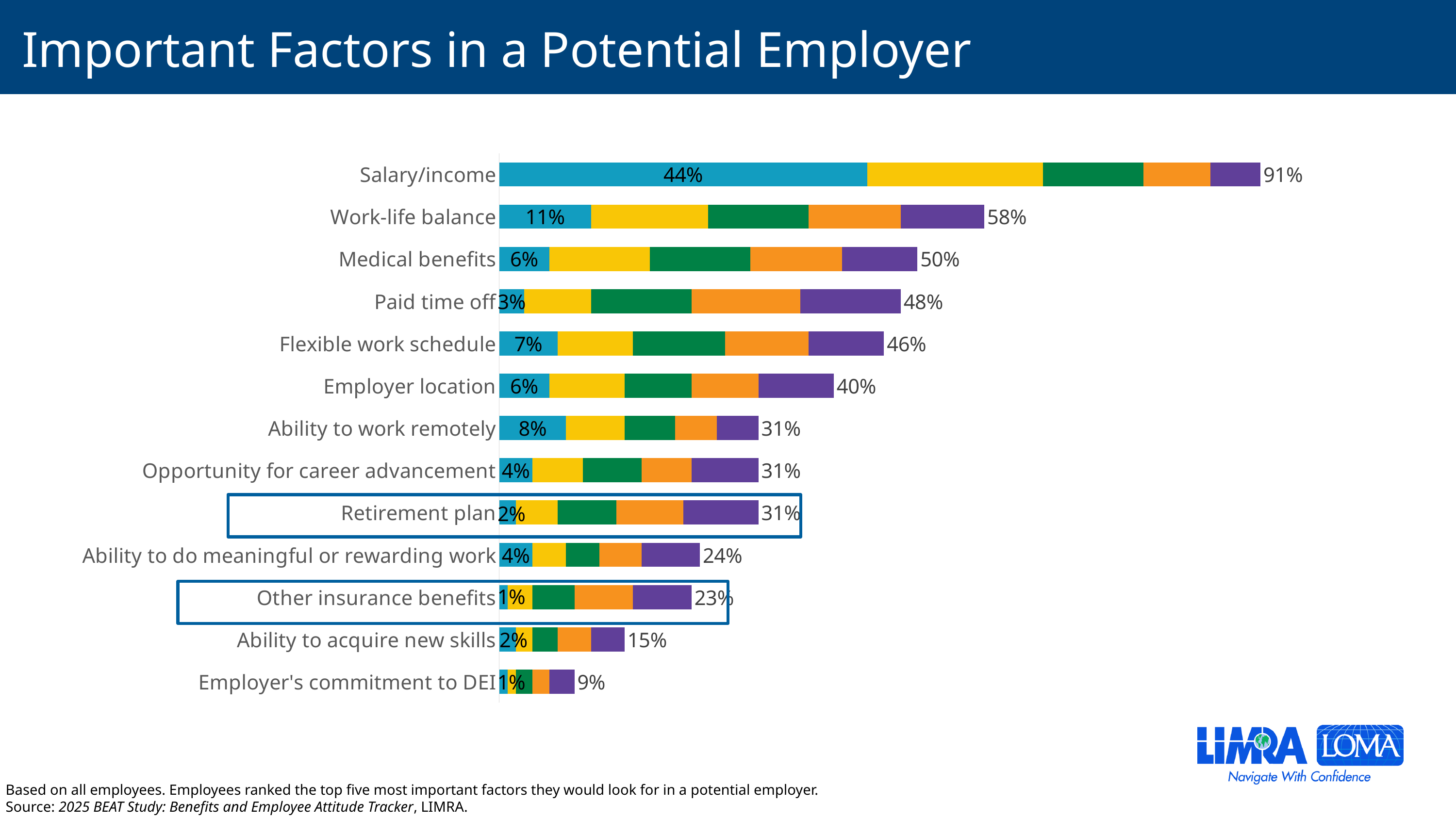
What is the difference between the total for Salary/income and the total for Work-life balance? 33 percentage points Which factor has the highest total percentage? Salary/income What is the total percentage shown for Work-life balance? 58% Which has a larger total percentage, Medical benefits or Paid time off? Medical benefits What is the value of the first (blue) segment for Work-life balance? 11% How many factors (categories) are plotted in the chart? 13 What is the total percentage shown for Salary/income? 91% What kind of chart is shown on the slide? Stacked bar chart Which two factors are outlined with boxes on the chart? Retirement plan and Other insurance benefits What is the value of the first (blue) segment for Salary/income? 44% Which factor has the lowest total percentage? Employer's commitment to DEI What is the total percentage shown for Retirement plan? 31%